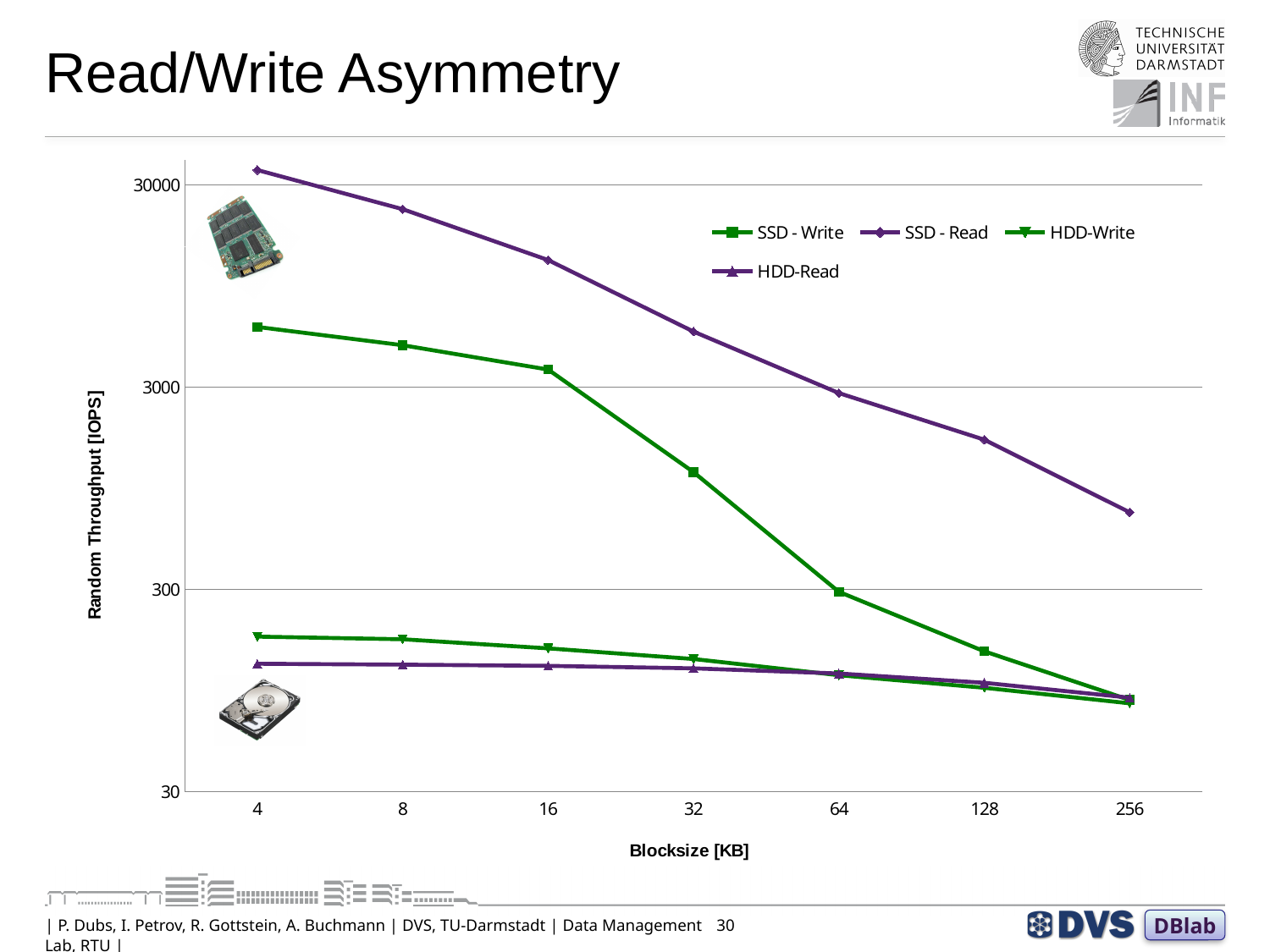
At a blocksize of 32 KB, which is larger: SSD - Read or SSD - Write? SSD - Read Which series has the highest throughput at a blocksize of 4 KB? SSD - Read Does the SSD - Write throughput rise or fall as blocksize increases? fall Is the SSD - Write value at a blocksize of 128 KB greater or less than 300? less What kind of chart is shown on the slide? line chart Is the SSD - Read value at a blocksize of 256 KB greater or less than 300? greater What is the label of the y axis? Random Throughput [IOPS] How many series does the legend list? 4 Is the SSD - Read value at a blocksize of 4 KB greater or less than 30000? greater How many blocksize values are plotted along the x axis? 7 Which series has the lowest throughput at a blocksize of 4 KB? HDD-Read